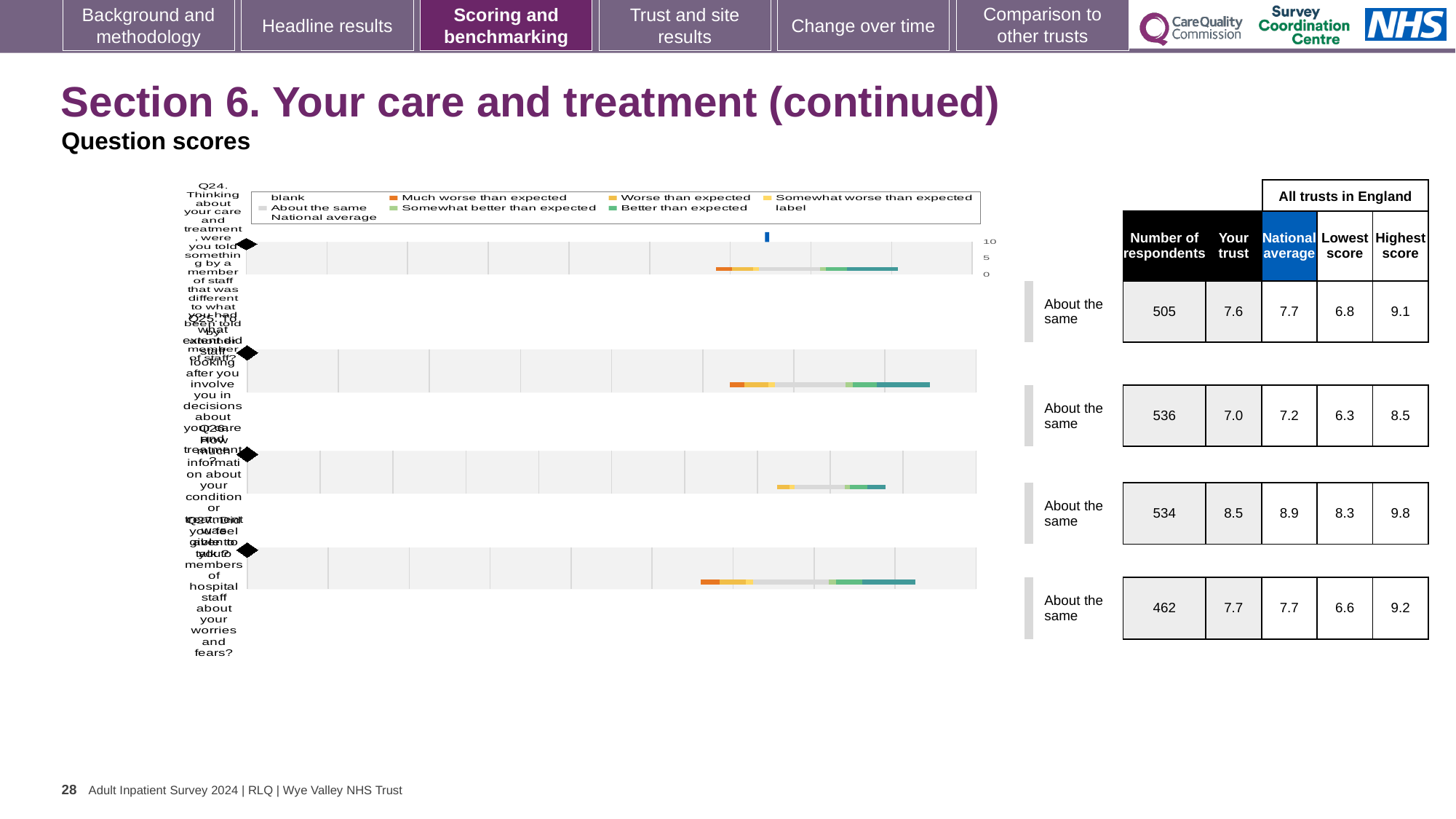
Which question has the lowest 'Your trust' score? Q25 What is the 'Your trust' score for Q24? 7.6 For Q26, what is the difference between the national average and the 'Your trust' score? 0.4 What is the highest score among all trusts in England for Q26? 9.8 What kind of chart is used to show the question scores on this slide? bar chart Which question has the highest 'Your trust' score? Q26 For Q24, which is larger: the 'Your trust' score or the national average? National average How many questions (Q24 to Q27) are plotted on the slide? 4 What is the national average score for Q25? 7.2 What benchmark category is shown for Q25? About the same How many respondents answered Q27? 462 What is the lowest score among all trusts in England for Q27? 6.6